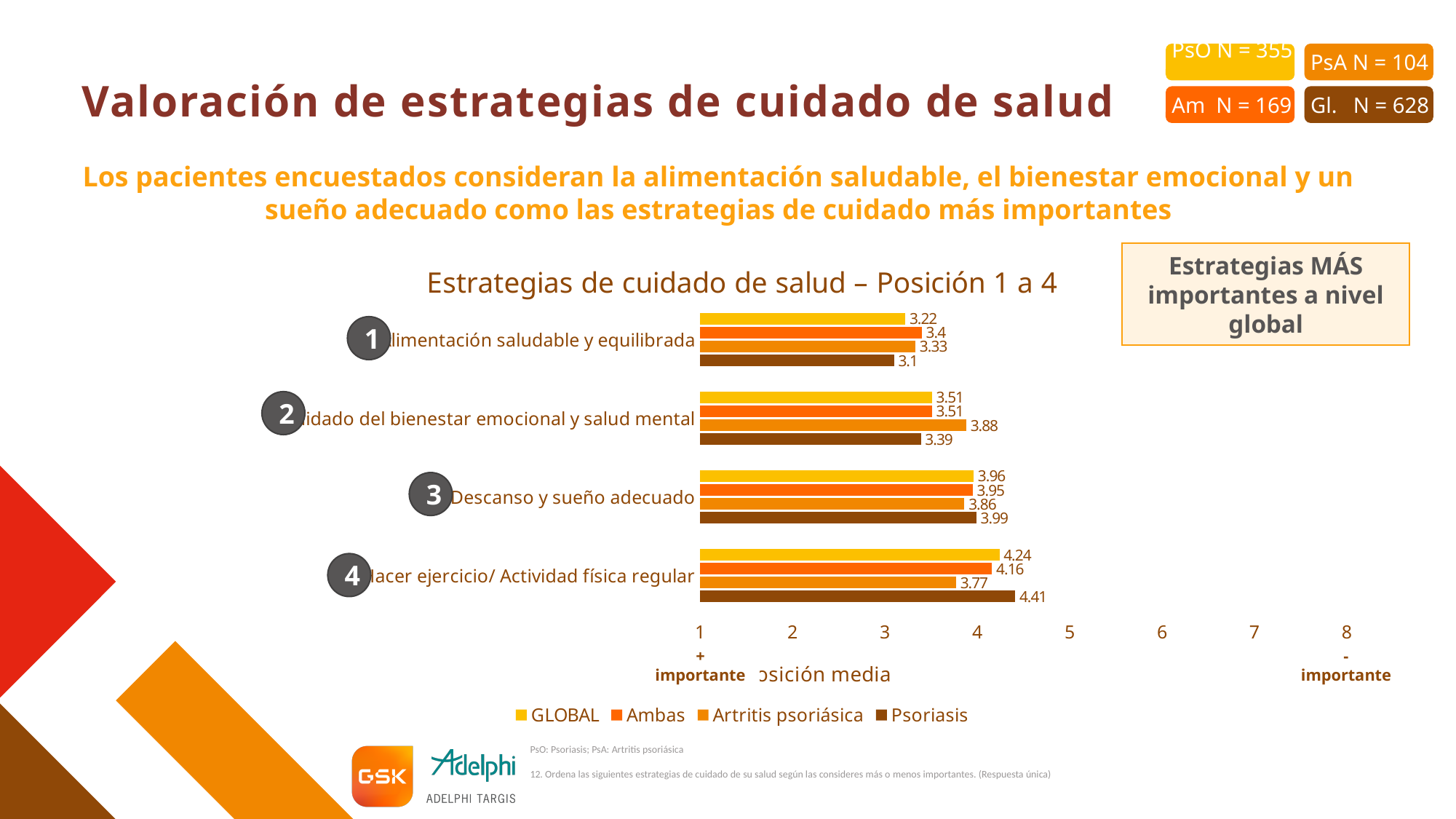
What is the title of the chart? Estrategias de cuidado de salud – Posición 1 a 4 What is the Ambas value for 'Descanso y sueño adecuado'? 3.95 What type of chart is shown on the slide? bar chart What is the GLOBAL value for 'Alimentación saludable y equilibrada'? 3.22 Which category has the lowest Psoriasis value? Alimentación saludable y equilibrada What is the Psoriasis value for 'Hacer ejercicio/ Actividad física regular'? 4.41 What is the difference between the Psoriasis value and the Artritis psoriásica value for 'Hacer ejercicio/ Actividad física regular'? 0.64 What is the Artritis psoriásica value for 'Cuidado del bienestar emocional y salud mental'? 3.88 How many health care strategies (categories) are plotted in the chart? 4 Which category has the highest GLOBAL value? Hacer ejercicio/ Actividad física regular How many series does the legend list? 4 For 'Alimentación saludable y equilibrada', which is larger: the Ambas value or the Psoriasis value? Ambas